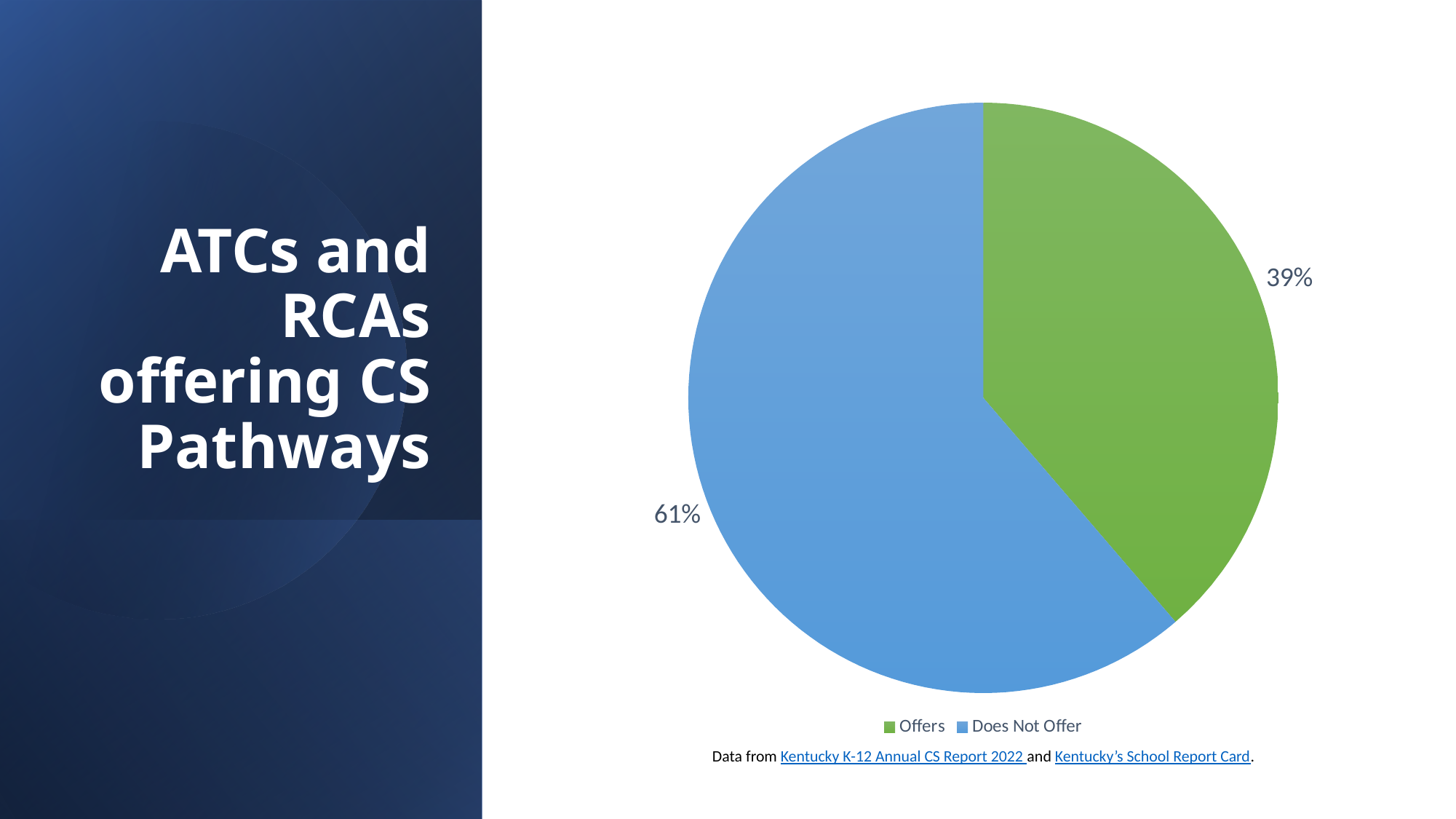
What share of the pie is labelled "Does Not Offer"? 61% How many slices does the pie chart have? 2 How many entries does the legend list? 2 What share of the pie is labelled "Offers"? 39% What kind of chart is shown on the slide? pie chart What is the difference in percentage points between the "Does Not Offer" slice and the "Offers" slice? 22 Which is larger, the "Offers" slice or the "Does Not Offer" slice? Does Not Offer Which slice is the smallest? Offers Which slice is the largest? Does Not Offer What colour is the "Offers" slice? green What colour is the "Does Not Offer" slice? blue